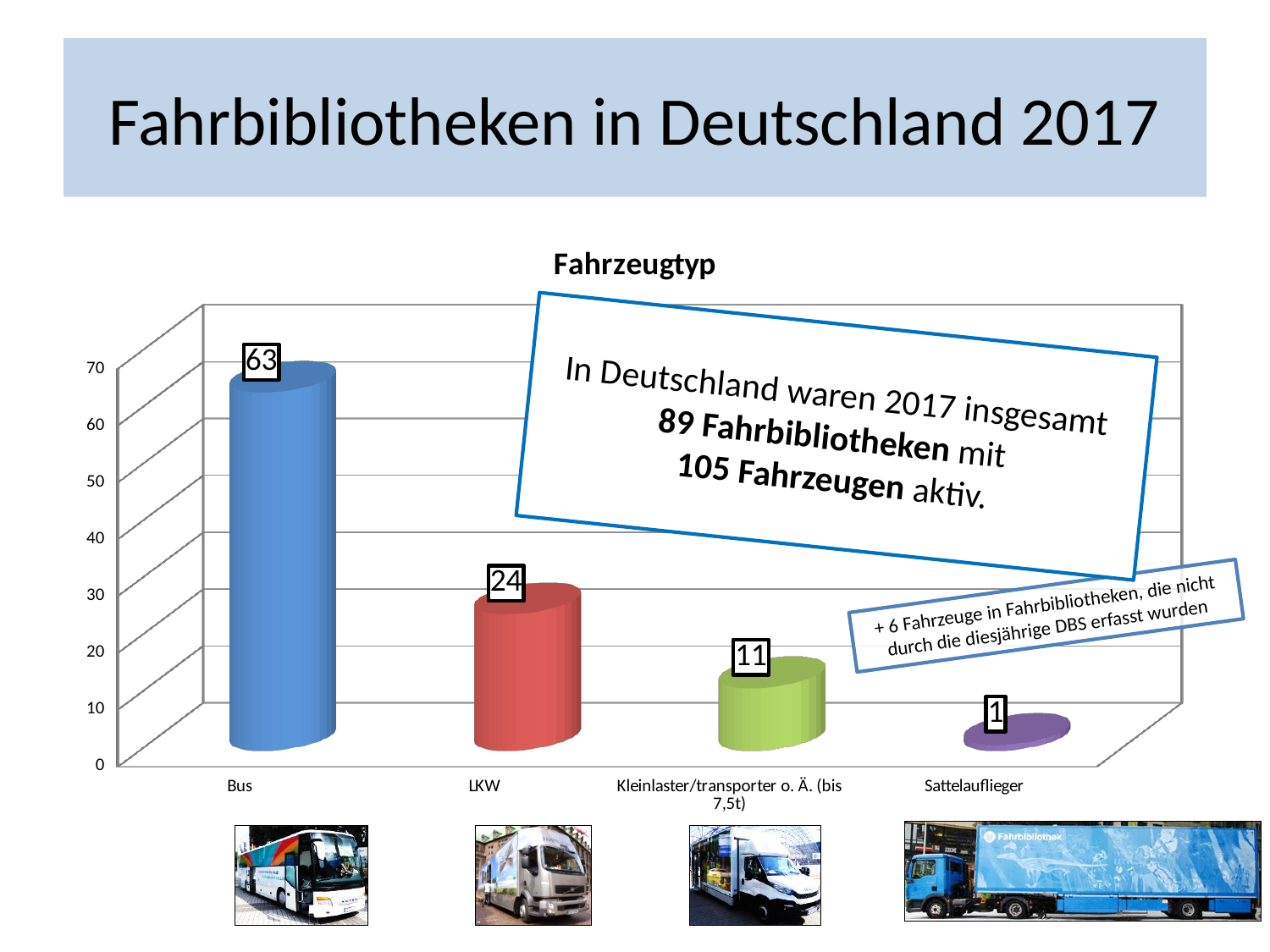
What is the value for Kleinlaster/transporter o. Ä. (bis 7,5t)? 11 How many vehicle types are shown in the chart? 4 Is the value for LKW greater or less than 30? less Which is larger, the value for LKW or the value for Kleinlaster/transporter o. Ä. (bis 7,5t)? LKW Which vehicle type has the highest value? Bus What kind of chart is shown on the slide? bar chart What is the value for LKW? 24 What is the title of the chart? Fahrzeugtyp What is the value for Sattelauflieger? 1 What is the difference between the values for Bus and LKW? 39 What is the value for Bus? 63 Which vehicle type has the lowest value? Sattelauflieger